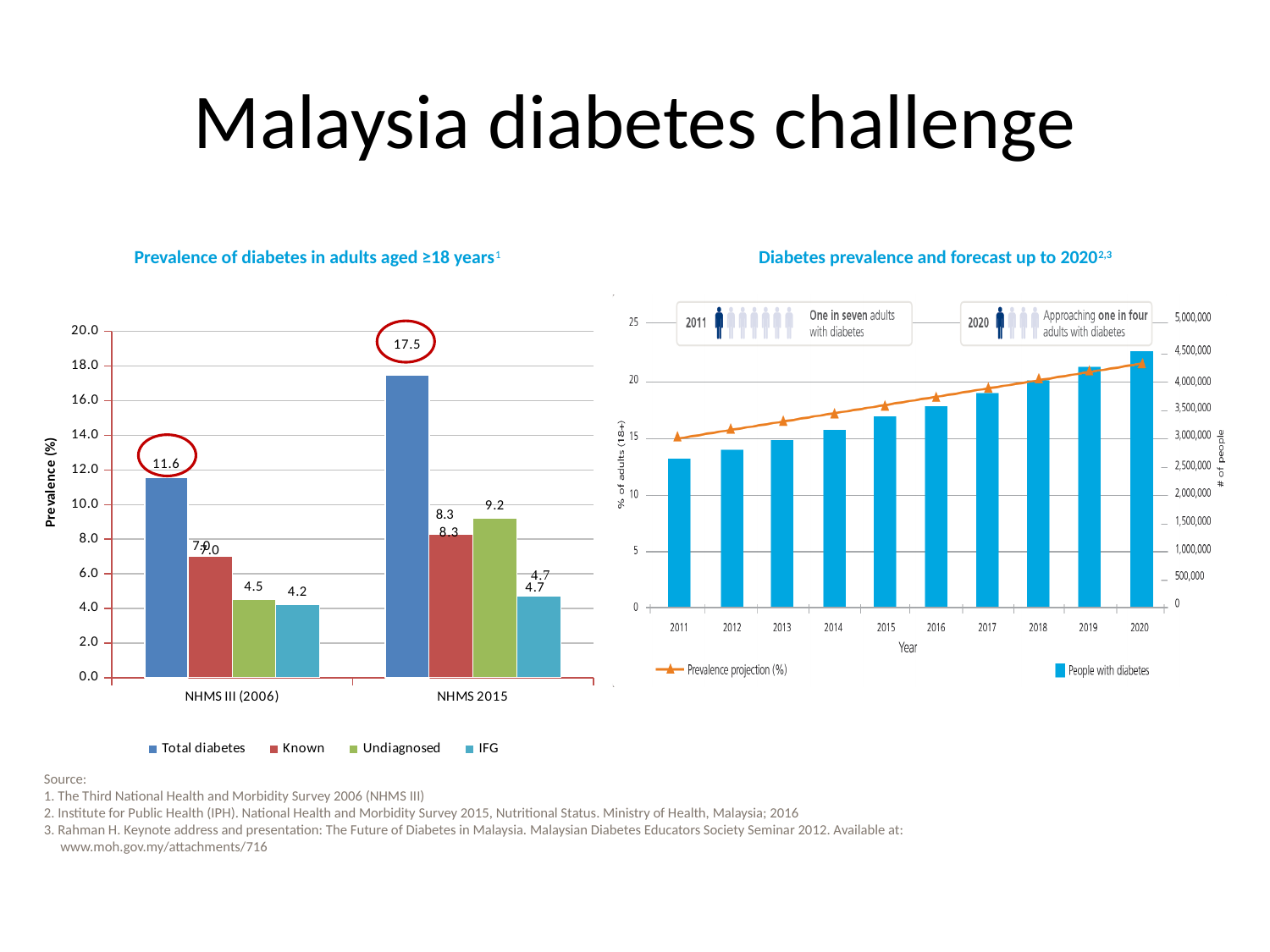
In the chart 'Diabetes prevalence and forecast up to 2020', does the prevalence projection rise or fall from 2011 to 2020? Rises In the chart 'Prevalence of diabetes in adults aged ≥18 years', what is the Total diabetes value for NHMS 2015? 17.5 In the chart 'Prevalence of diabetes in adults aged ≥18 years', which is larger for NHMS 2015: Known or Undiagnosed? Undiagnosed In the chart 'Prevalence of diabetes in adults aged ≥18 years', what is the Undiagnosed value for NHMS 2015? 9.2 In the chart 'Diabetes prevalence and forecast up to 2020', is the number of people with diabetes in 2011 greater or less than 3,000,000? less In the chart 'Prevalence of diabetes in adults aged ≥18 years', what is the Known value for NHMS III (2006)? 7.0 How many series does the legend of the chart 'Prevalence of diabetes in adults aged ≥18 years' list? 4 In the chart 'Prevalence of diabetes in adults aged ≥18 years', what is the IFG value for NHMS III (2006)? 4.2 In the chart 'Prevalence of diabetes in adults aged ≥18 years', which bar has the highest value? Total diabetes, NHMS 2015 In the chart 'Diabetes prevalence and forecast up to 2020', how many years are shown on the x axis? 10 What kind of chart is 'Prevalence of diabetes in adults aged ≥18 years'? Bar chart In the chart 'Prevalence of diabetes in adults aged ≥18 years', by how much did Total diabetes increase from NHMS III (2006) to NHMS 2015? 5.9